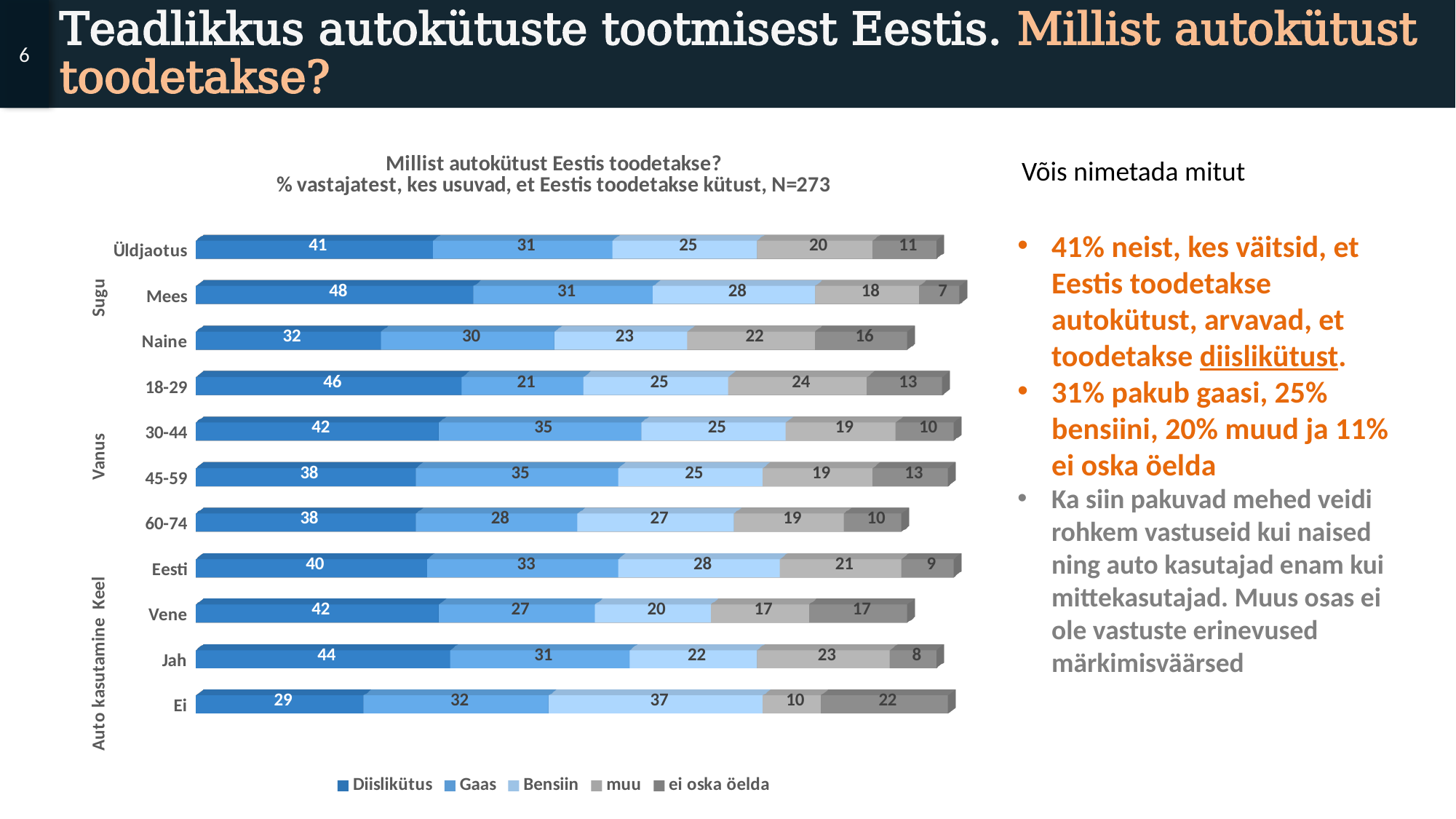
What kind of chart is shown on the slide? Stacked bar chart What is the total of the stacked bar for Üldjaotus? 128 How many categories are shown on the y axis of the chart? 11 What is the 'ei oska öelda' value for Mees? 7 What is the Diislikütus value for Üldjaotus? 41 Which category has the lowest Diislikütus value? Ei Which category has the highest Diislikütus value? Mees Which is larger, the Gaas value for 30-44 or the Gaas value for 18-29? 30-44 How many series does the legend list? 5 What is the difference between the Diislikütus values for Mees and Naine? 16 What is the N value stated in the chart subtitle? N=273 What is the Bensiin value for the Ei category? 37